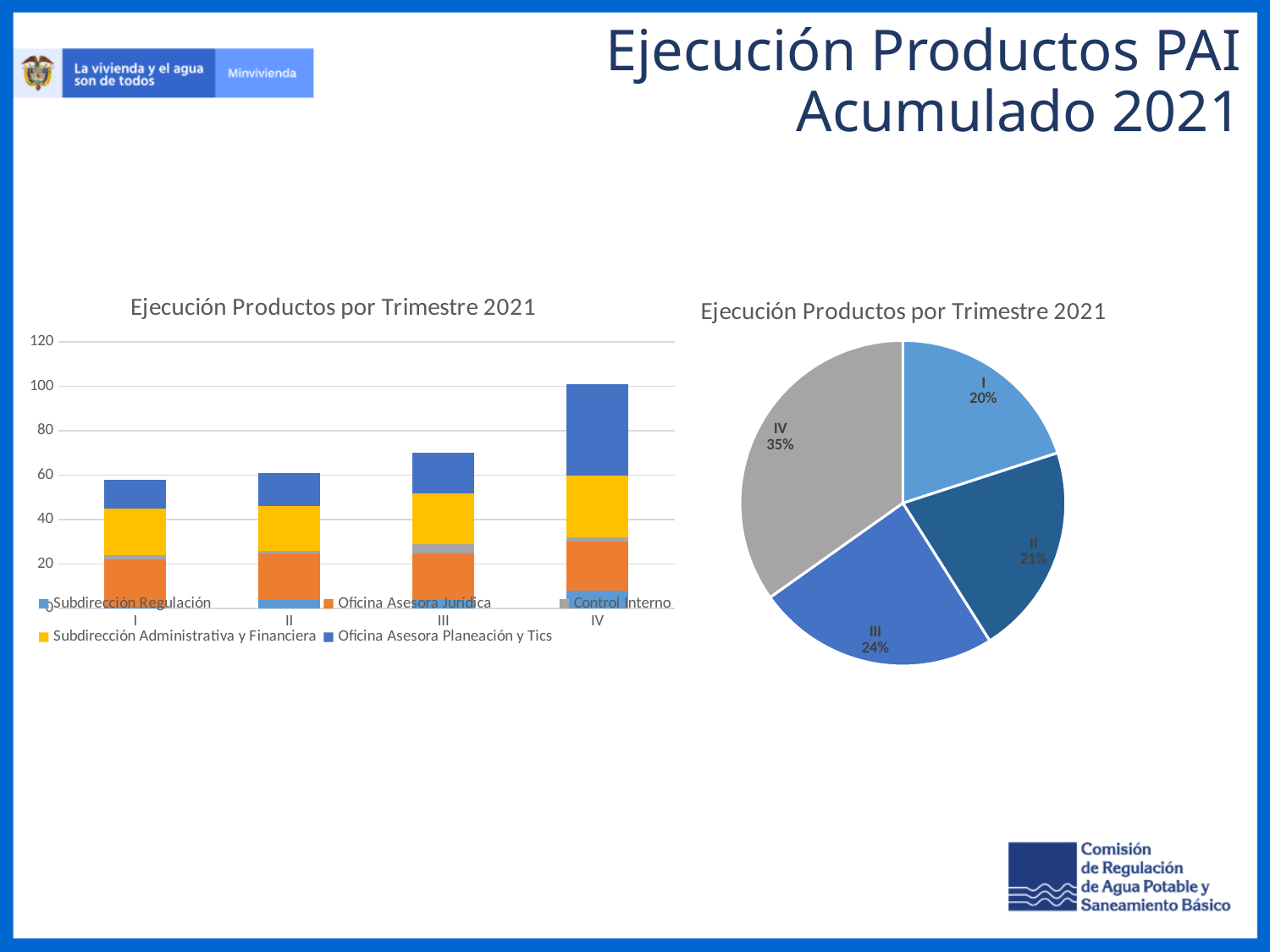
In the pie chart on the right, what share does quarter III have? 24% In the pie chart on the right, how many slices are there? 4 In the bar chart on the left, how many series does the legend list? 5 In the pie chart on the right, what share does quarter IV have? 35% In the pie chart on the right, how many percentage points larger is the share of quarter IV than the share of quarter I? 15 In the bar chart on the left, is the total height of the stacked bar for quarter IV greater or less than 80? greater What kind of chart is the chart on the right of the slide? pie chart In the bar chart on the left, do the total bar heights rise or fall from quarter I to quarter IV? rise In the bar chart on the left, is the total height of the stacked bar for quarter III greater or less than 60? greater What kind of chart is the chart on the left of the slide? bar chart In the pie chart on the right, which quarter has the largest share? IV In the pie chart on the right, which quarter has the smallest share? I